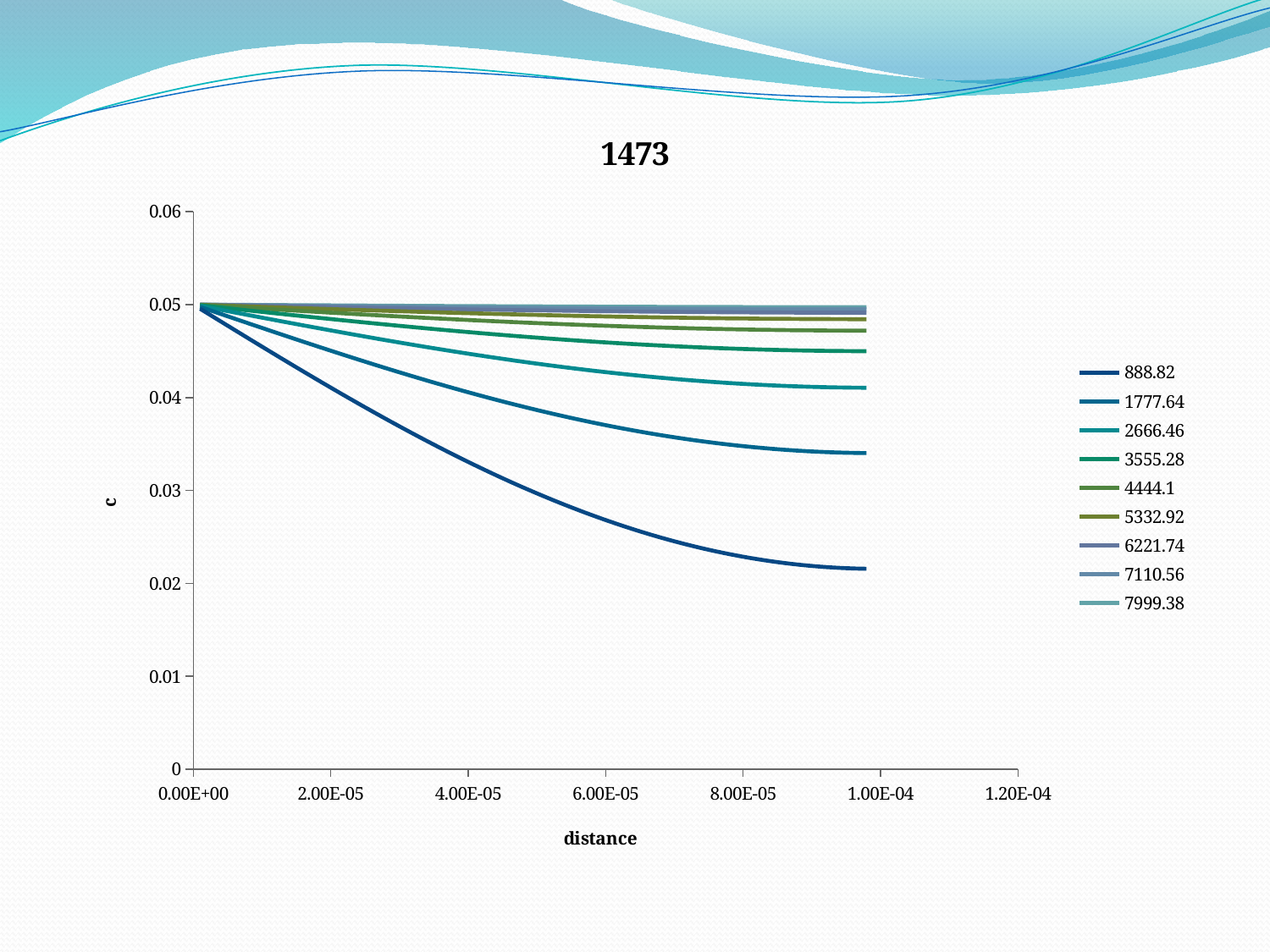
Is the value of the 888.82 series at its right end greater or less than 0.03? less What is the title of the chart? 1473 What kind of chart is shown on the slide? line chart At the right end of the chart, which series has the larger value of c, 888.82 or 1777.64? 1777.64 Is the value of the 3555.28 series at its right end greater or less than 0.04? greater Is the value of the 1777.64 series at its right end greater or less than 0.03? greater How many series does the legend list? 9 What is the label of the x axis? distance Does the value of the 888.82 series rise or fall as distance increases? fall At the right end of the chart, which series has the larger value of c, 2666.46 or 3555.28? 3555.28 Which series reaches the lowest value of c at the right end of the chart? 888.82